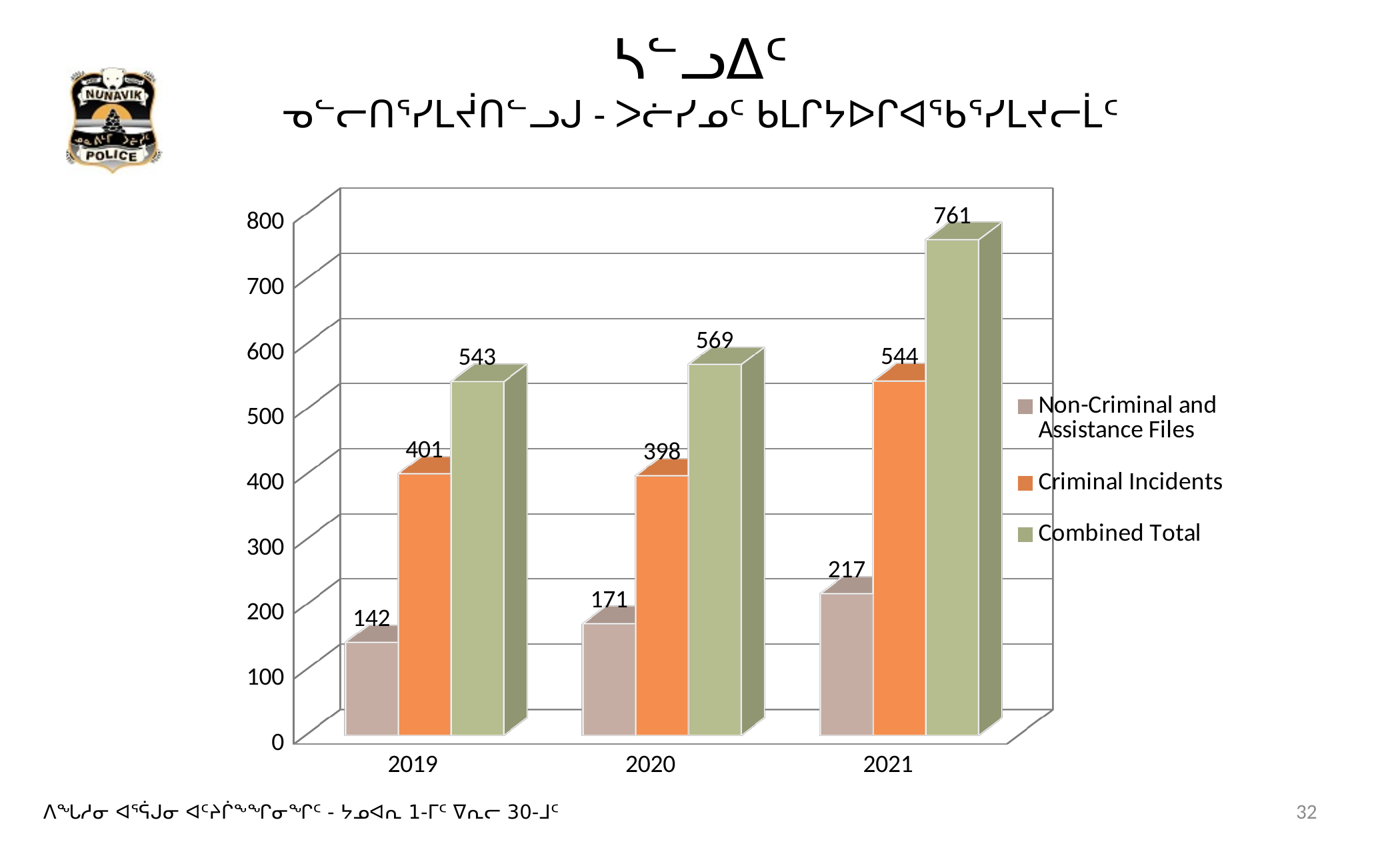
What is the value of Criminal Incidents in 2021? 544 How many years are shown on the x axis? 3 In which year is the Combined Total highest? 2021 What is the difference between Criminal Incidents in 2021 and in 2020? 146 What is the Combined Total for 2020? 569 What kind of chart is shown on the slide? bar chart Does the Combined Total rise or fall from 2019 to 2021? rise What is the value of Non-Criminal and Assistance Files in 2019? 142 Which is larger: Criminal Incidents in 2019 or Criminal Incidents in 2020? 2019 How many series does the legend list? 3 In which year is the value for Non-Criminal and Assistance Files lowest? 2019 What is the difference between the Combined Total in 2021 and in 2019? 218